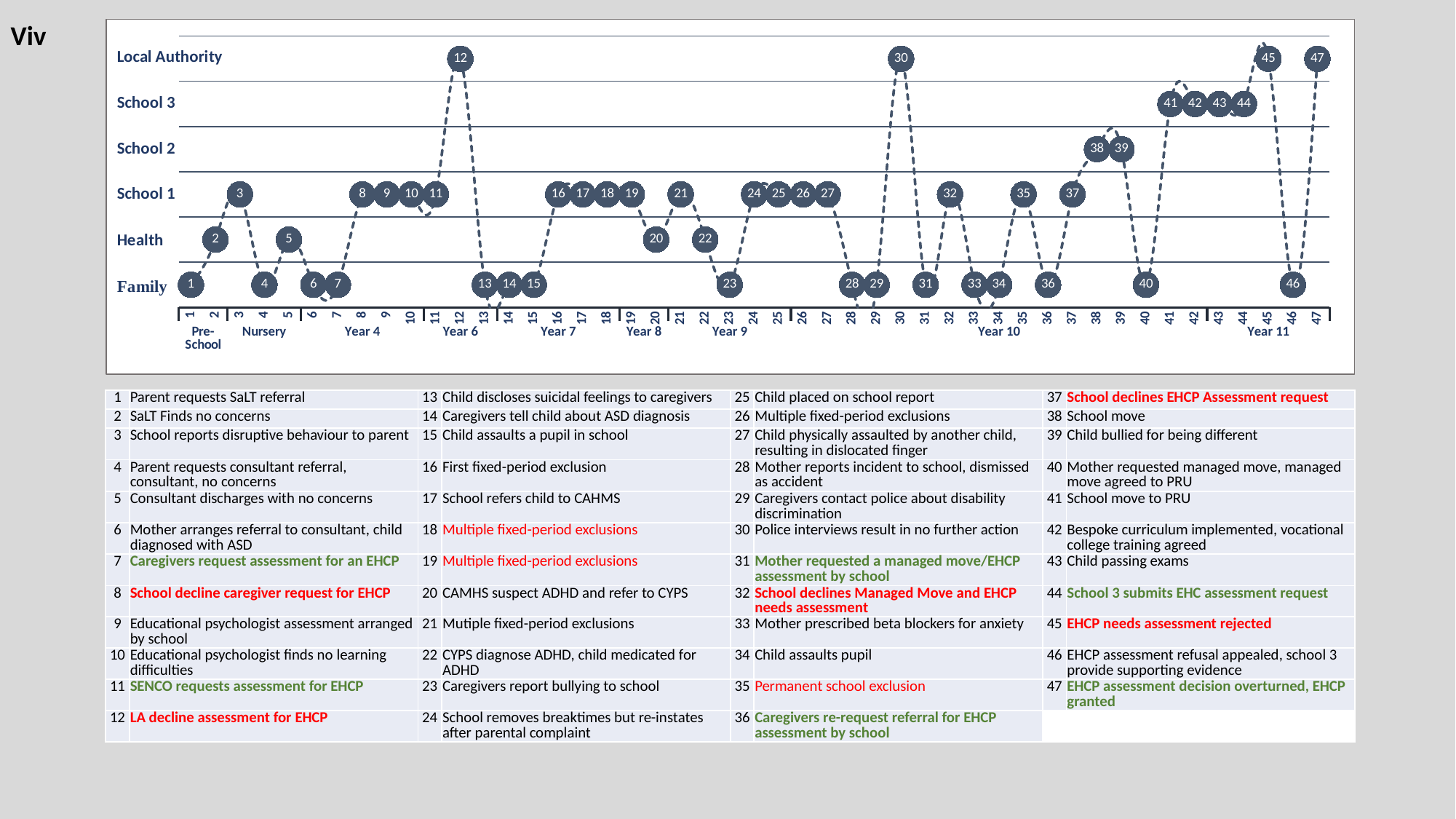
Which school year label appears beneath event 12 on the x axis? Year 6 How many events are plotted on the School 2 row? 2 What is the highest event number plotted on the chart? 47 Which row of the chart has the most events plotted on it? School 1 On which row of the chart is event 12 plotted? Local Authority What kind of chart is shown on the slide? Line chart How many row categories are listed on the vertical axis of the chart? 6 On which row of the chart is event 20 plotted? Health On which row of the chart is event 38 plotted? School 2 On which row of the chart is event 1 plotted? Family On which row of the chart is event 41 plotted? School 3